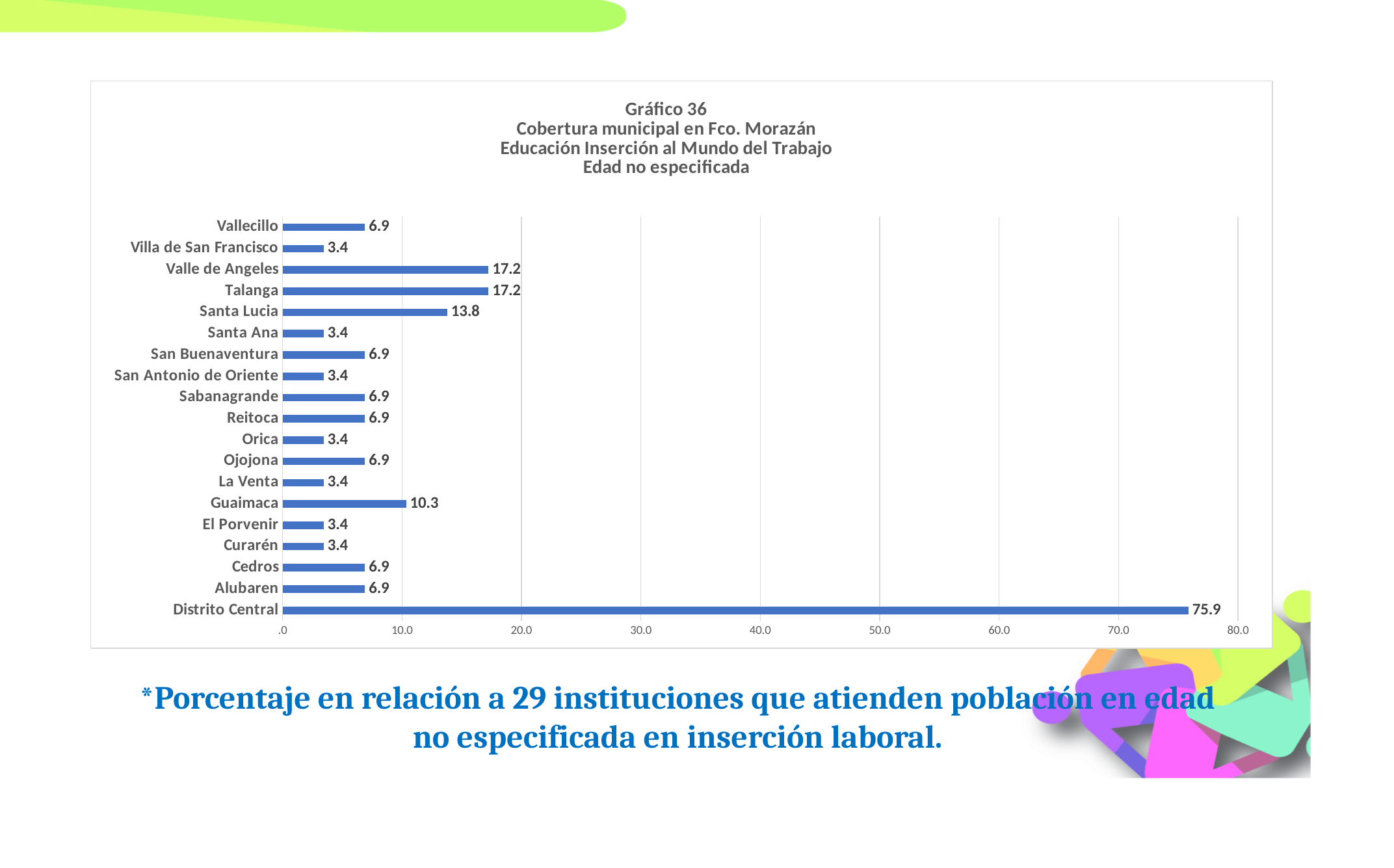
What is the value for Santa Lucia? 13.8 Which is larger, the value for Valle de Angeles or the value for Santa Lucia? Valle de Angeles What kind of chart is shown on the slide? Bar chart What is the difference between the values for Distrito Central and Talanga? 58.7 What is the number of the chart given in its title? Gráfico 36 What is the value for Distrito Central? 75.9 What is the difference between the values for Santa Lucia and Guaimaca? 3.5 What is the value for Guaimaca? 10.3 Is the value for Distrito Central greater or less than 70.0? greater What is the value for Villa de San Francisco? 3.4 Which municipality has the highest value? Distrito Central How many municipalities are shown in the chart? 19